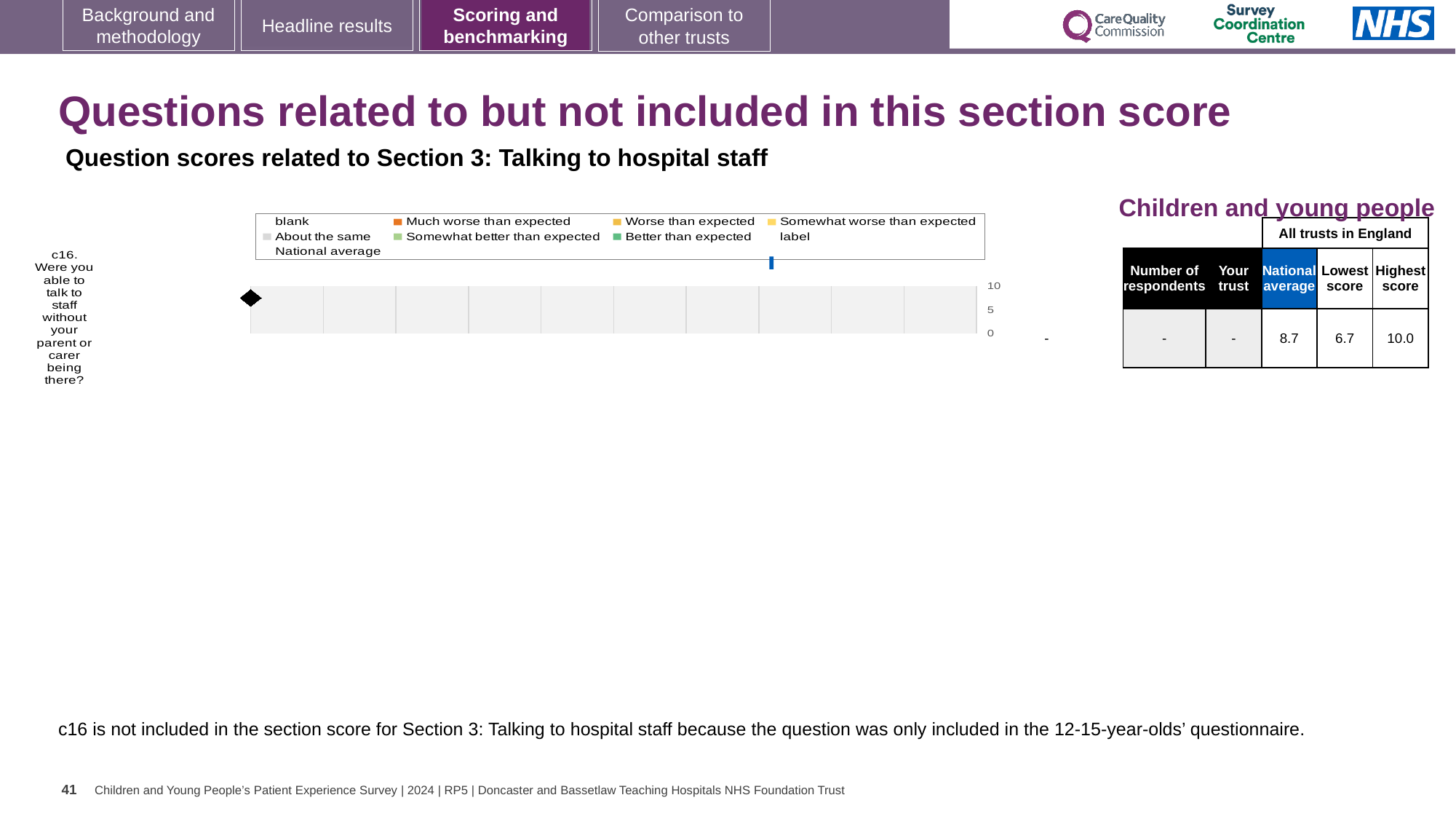
In the table next to the chart, what value is shown for Your trust for c16? - What kind of chart is shown on the slide? bar chart In the table next to the chart, which is larger for c16: the National average or the Lowest score? National average What is the highest value shown on the chart's value axis? 10 How many question categories are shown on the chart's vertical axis? 1 In the table next to the chart, what is the Lowest score across all trusts in England for c16? 6.7 In the table next to the chart, what is the difference between the Highest score and the Lowest score for c16? 3.3 In the table next to the chart, what is the Highest score across all trusts in England for c16? 10.0 In the table next to the chart, what is the National average score for c16? 8.7 Which question is listed as the category on the chart? c16. Were you able to talk to staff without your parent or carer being there?